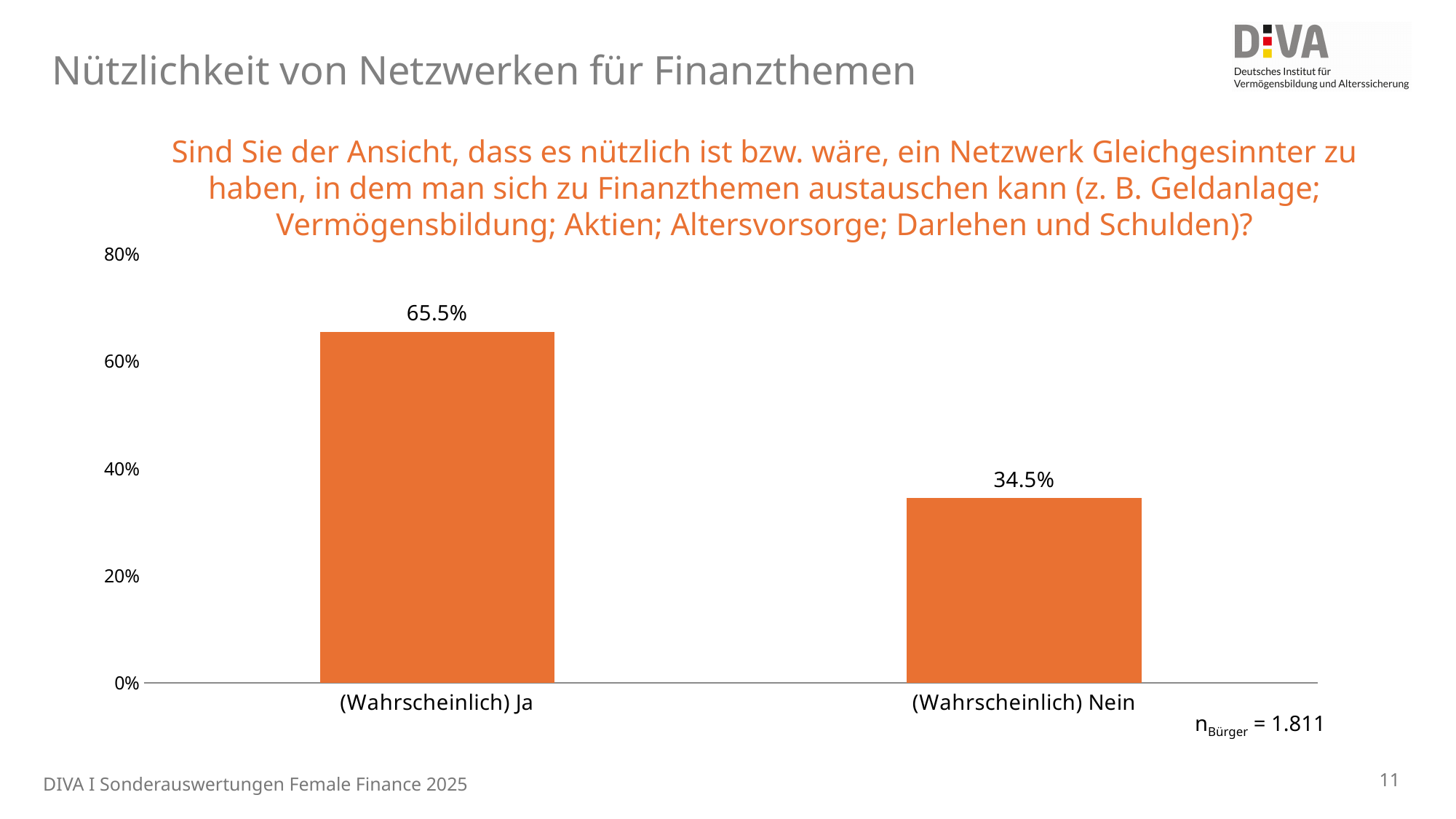
Which category has the highest value? (Wahrscheinlich) Ja What is the difference between the values for "(Wahrscheinlich) Ja" and "(Wahrscheinlich) Nein"? 31.0% What sample size (n) is stated below the chart? 1.811 Is the value for "(Wahrscheinlich) Nein" greater or less than 40%? less What is the highest value shown on the vertical axis? 80% What is the value for "(Wahrscheinlich) Ja"? 65.5% Is the value for "(Wahrscheinlich) Ja" greater or less than 60%? greater Which is larger, the value for "(Wahrscheinlich) Ja" or for "(Wahrscheinlich) Nein"? (Wahrscheinlich) Ja What is the value for "(Wahrscheinlich) Nein"? 34.5% How many categories are shown in the chart? 2 Which category has the lowest value? (Wahrscheinlich) Nein What kind of chart is shown on the slide? bar chart